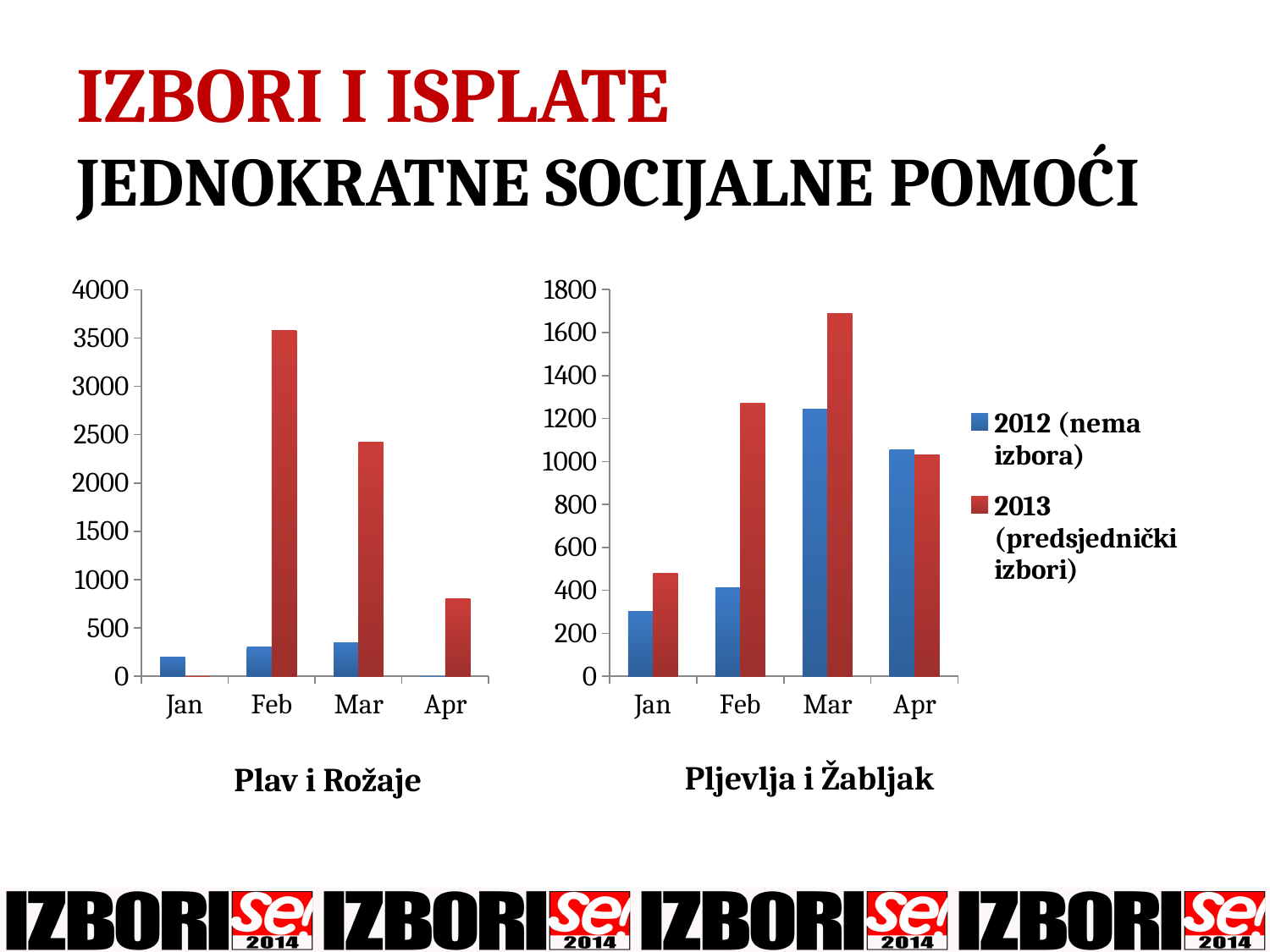
How many months are shown on the x axis of the "Pljevlja i Žabljak" chart? 4 In the "Pljevlja i Žabljak" chart, is the 2013 (predsjednički izbori) value for Mar greater or less than 1600? greater How many series does the legend list for the charts? 2 What kind of chart is the "Plav i Rožaje" chart? bar chart In the "Pljevlja i Žabljak" chart, which month has the lowest value for the 2012 (nema izbora) series? Jan In the "Pljevlja i Žabljak" chart, which month has the highest value for the 2013 (predsjednički izbori) series? Mar What colour are the bars for the 2013 (predsjednički izbori) series? red In the "Pljevlja i Žabljak" chart, do the 2012 (nema izbora) values rise or fall from Jan to Mar? rise In the "Plav i Rožaje" chart, which month has the highest value for the 2013 (predsjednički izbori) series? Feb In the "Plav i Rožaje" chart, is the 2013 (predsjednički izbori) value for Feb greater or less than 3000? greater In the "Plav i Rožaje" chart, is the 2012 (nema izbora) value for Mar greater or less than 500? less In the "Pljevlja i Žabljak" chart, which is larger for Feb: the 2012 (nema izbora) value or the 2013 (predsjednički izbori) value? 2013 (predsjednički izbori)